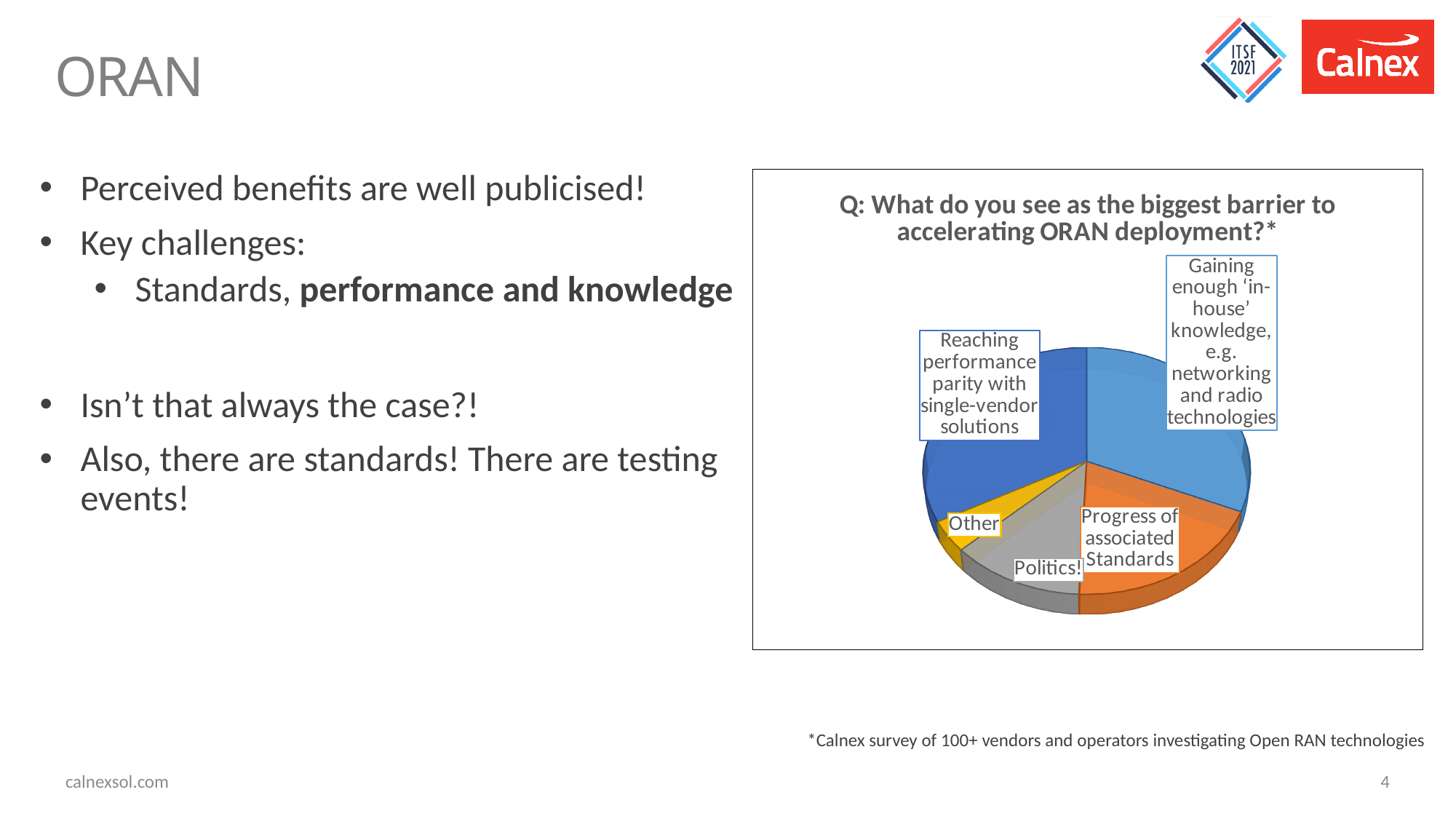
Which slice is larger: 'Reaching performance parity with single-vendor solutions' or 'Progress of associated Standards'? Reaching performance parity with single-vendor solutions Which slice of the pie chart is the smallest? Other Which slice is larger: 'Politics!' or 'Other'? Politics! Which slice is larger: 'Reaching performance parity with single-vendor solutions' or 'Politics!'? Reaching performance parity with single-vendor solutions What kind of chart is shown on the slide? pie chart What colour is the 'Other' slice in the pie chart? yellow How many slices does the pie chart have? 5 What is the title of the pie chart? Q: What do you see as the biggest barrier to accelerating ORAN deployment?*